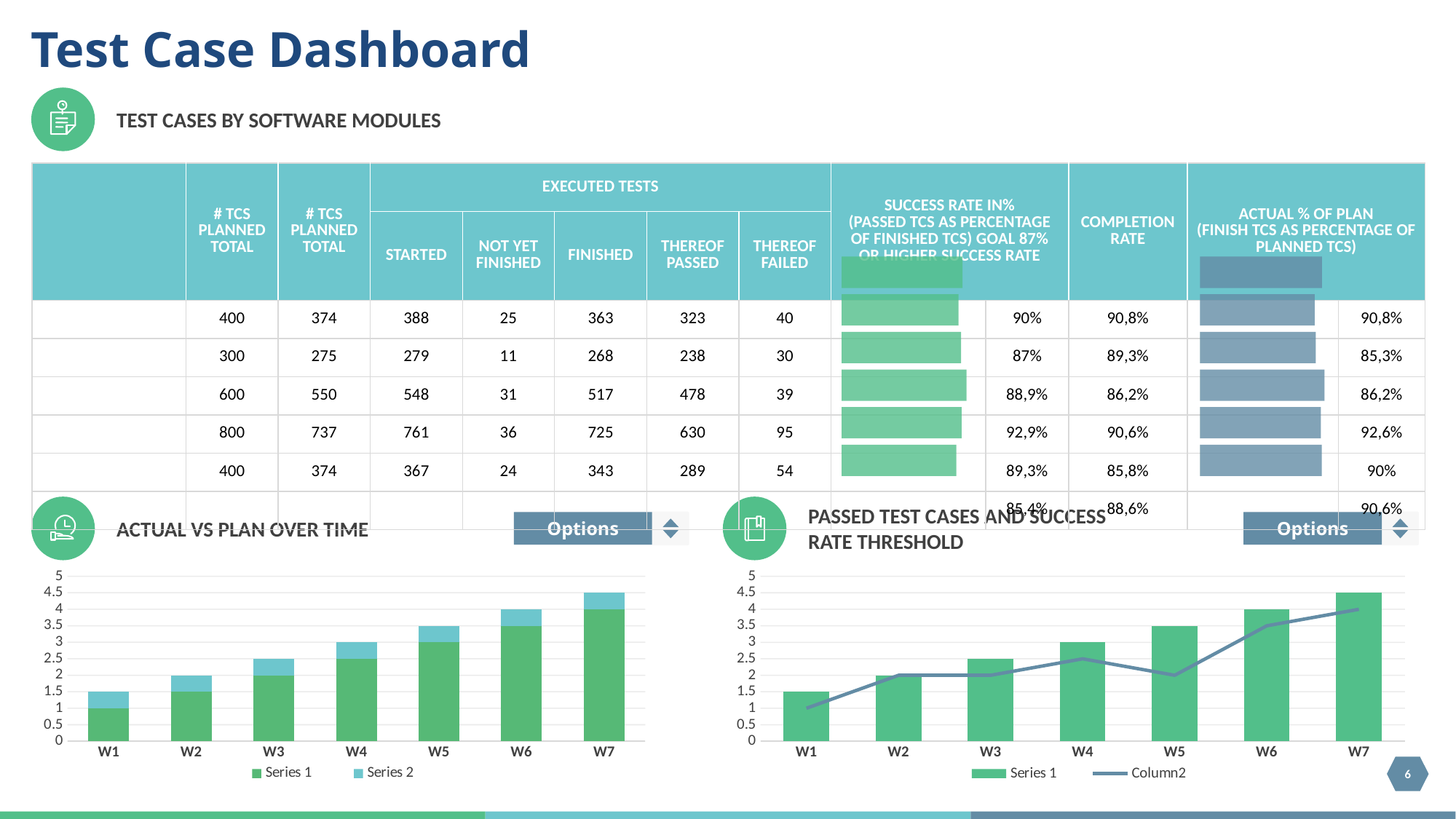
In the 'Actual vs Plan over time' chart, which week has the lowest stacked bar total? W1 In the 'Actual vs Plan over time' chart, what kind of chart is it? bar chart In the 'Passed test cases and success rate threshold' chart, what is the Series 1 value for W5? 3.5 In the 'Passed test cases and success rate threshold' chart, what is the difference between the Series 1 values for W7 and W1? 3 In the 'Actual vs Plan over time' chart, how many series does the legend list? 2 In the 'Actual vs Plan over time' chart, what is the value of Series 1 for W4? 2.5 In the 'Actual vs Plan over time' chart, what is the total height of the stacked bar for W7? 4.5 In the 'Actual vs Plan over time' chart, do the stacked bar totals rise or fall from W1 to W7? rise In the 'Passed test cases and success rate threshold' chart, which is larger at W5: the Series 1 bar or the Column2 line? Series 1 bar In the 'Passed test cases and success rate threshold' chart, which week has the highest Series 1 bar? W7 In the 'Passed test cases and success rate threshold' chart, what is the Column2 line value for W6? 3.5 In the 'Actual vs Plan over time' chart, how many categories are shown on the x axis? 7